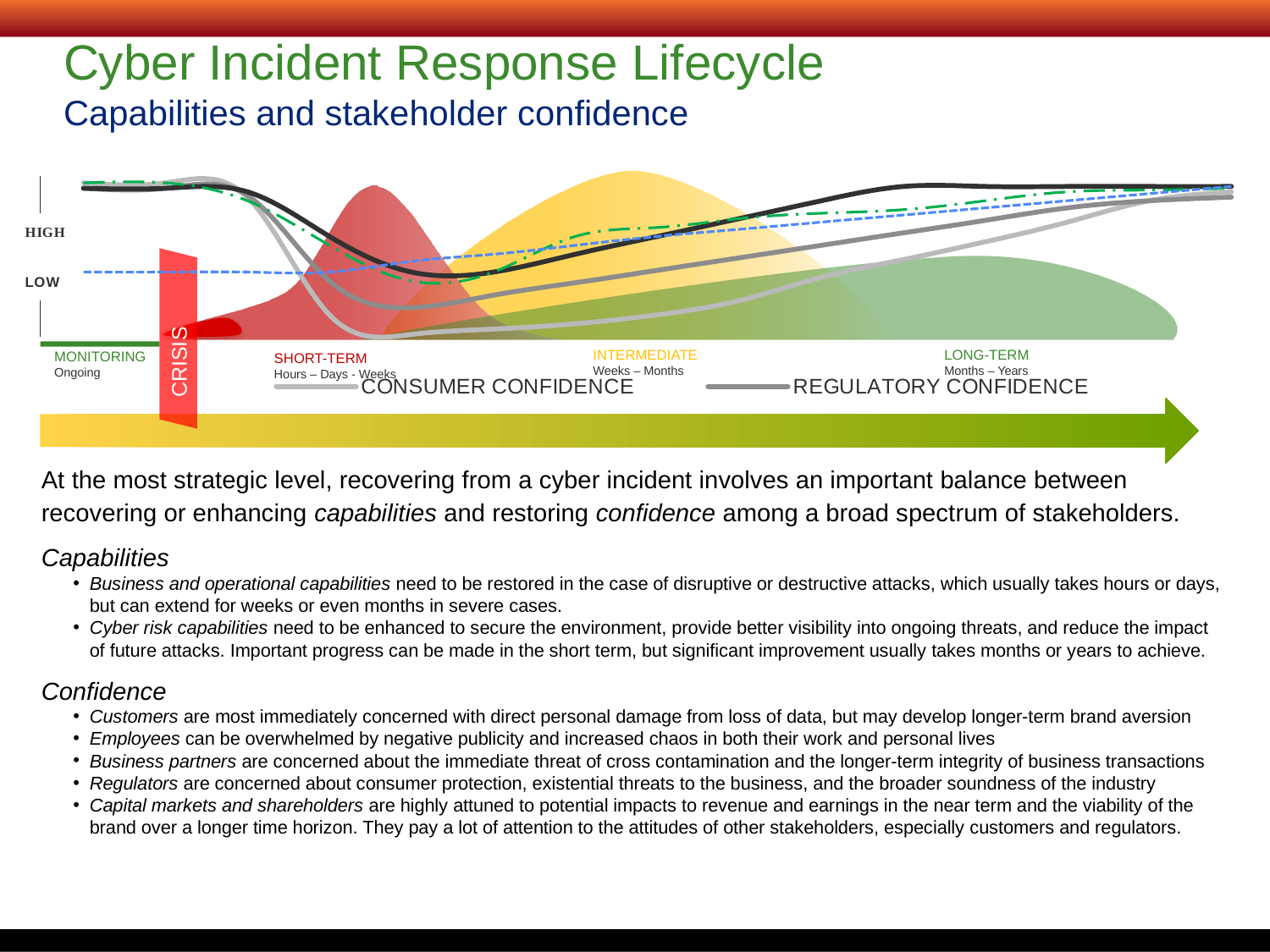
What are the two labels shown on the chart's vertical axis? HIGH and LOW Which phase on the chart's x axis is labelled with the time frame 'Months – Years'? Long-term Which phase on the chart's x axis is labelled with the time frame 'Weeks – Months'? Intermediate What is the title of the chart's slide? Cyber Incident Response Lifecycle How many series does the chart's legend list? 2 How many phases are labelled along the x axis of the chart (Monitoring, Crisis, Short-term, Intermediate, Long-term)? 5 What are the two series named in the chart's legend? Consumer Confidence and Regulatory Confidence What kind of chart is shown on the slide? line chart What time frame is printed under the Short-term phase on the chart? Hours – Days - Weeks Does consumer confidence rise or fall as the chart moves from the Monitoring phase into the Crisis and Short-term phases? fall Does consumer confidence rise or fall across the Intermediate and Long-term phases of the chart? rise What time frame is printed under the Monitoring phase on the chart? Ongoing